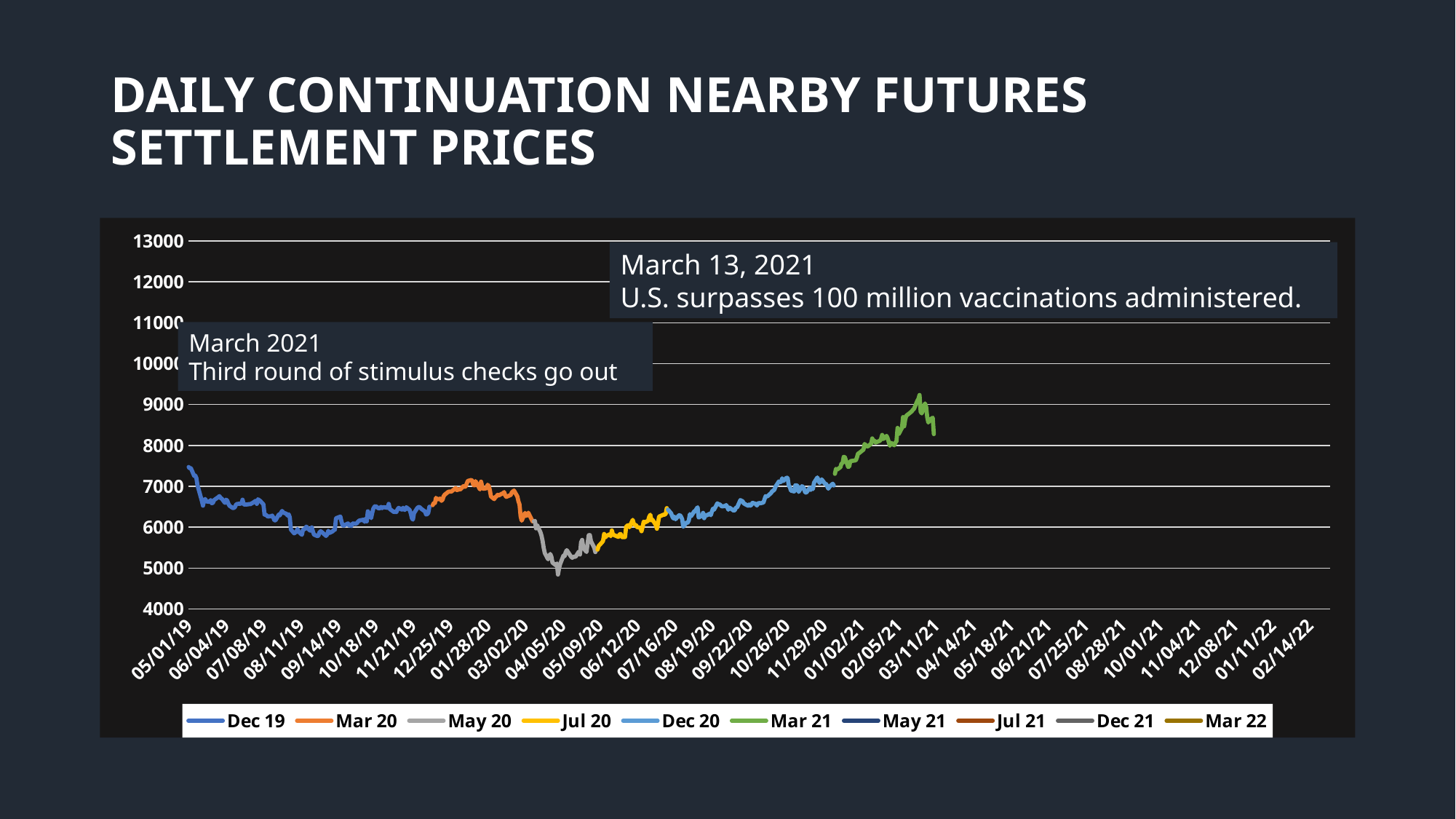
What is the highest value shown on the y axis? 13000 Which series reaches the lowest value on the chart? May 20 Does the Dec 19 series rise or fall between 05/01/19 and 08/11/19? fall Is the peak value of the Mar 21 series greater or less than 8000? greater What is the title of the chart? Daily Continuation Nearby Futures Settlement Prices How many series does the legend list? 10 Does the Mar 21 series generally rise or fall over its plotted range? rise Is the lowest value of the May 20 series greater or less than 6000? less What kind of chart is shown on the slide? line chart Which series reaches the highest value on the chart? Mar 21 Is the first value of the Dec 19 series (at 05/01/19) greater or less than 7000? greater